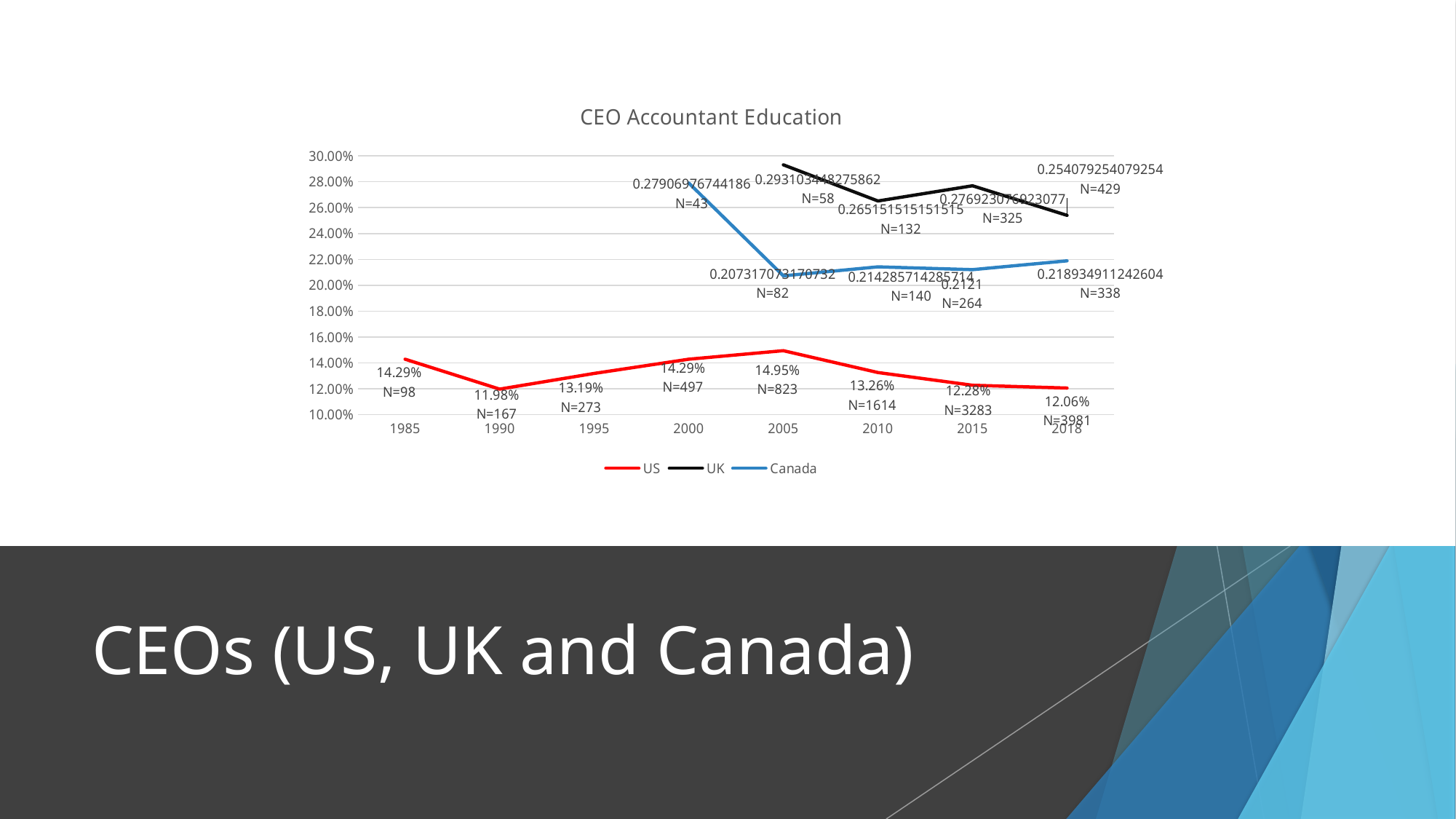
In which year is the US series at its highest? 2005 Is the value for Canada in 2000 greater or less than 26.00%? greater What is the US value for 1990? 11.98% How many years are shown on the x axis? 8 What is the US value for 2005? 14.95% In which year is the US series at its lowest? 1990 What is the difference between the US values for 2005 and 2018? 2.89 percentage points How many series does the legend list? 3 What is the data label shown for the UK in 2005? 0.293103448275862 What is the sample size (N) shown for the US in 2018? N=3981 What kind of chart is shown on the slide? Line chart In 2010, which series has the larger value, UK or Canada? UK